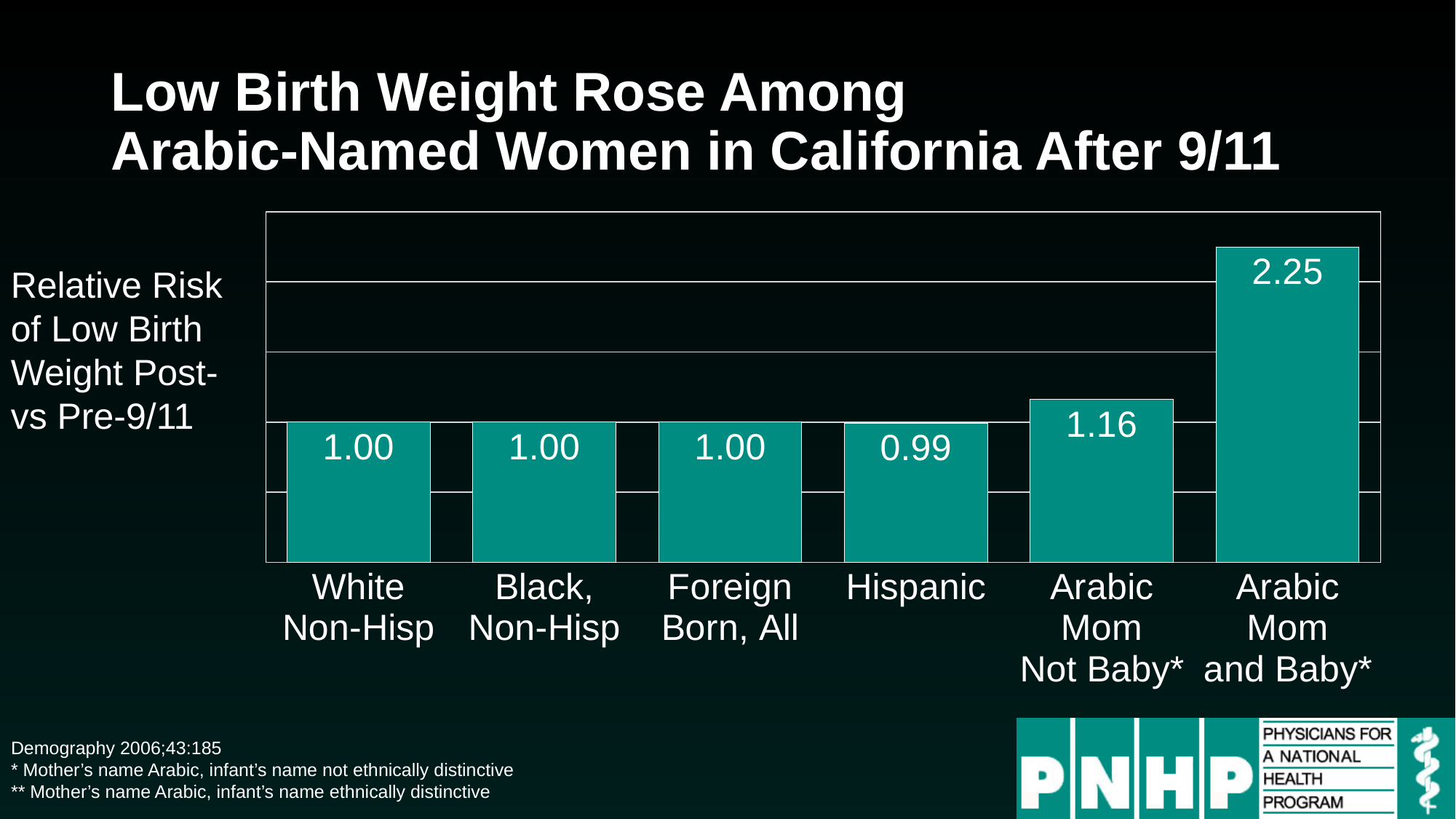
How many categories are shown in the bar chart? 6 What is the difference in relative risk between Arabic Mom and Baby and Arabic Mom Not Baby? 1.09 What is the relative risk of low birth weight for Arabic Mom and Baby? 2.25 What is the difference in relative risk between Arabic Mom Not Baby and Hispanic? 0.17 What is the title of the slide containing the chart? Low Birth Weight Rose Among Arabic-Named Women in California After 9/11 What type of chart is shown on the slide? Bar chart What is the relative risk of low birth weight for Hispanic? 0.99 Which has a higher relative risk, Arabic Mom Not Baby or Foreign Born, All? Arabic Mom Not Baby Which category has the highest relative risk of low birth weight? Arabic Mom and Baby What is the relative risk of low birth weight for White Non-Hisp? 1.00 Which category has the lowest relative risk of low birth weight? Hispanic What is the relative risk of low birth weight for Arabic Mom Not Baby? 1.16